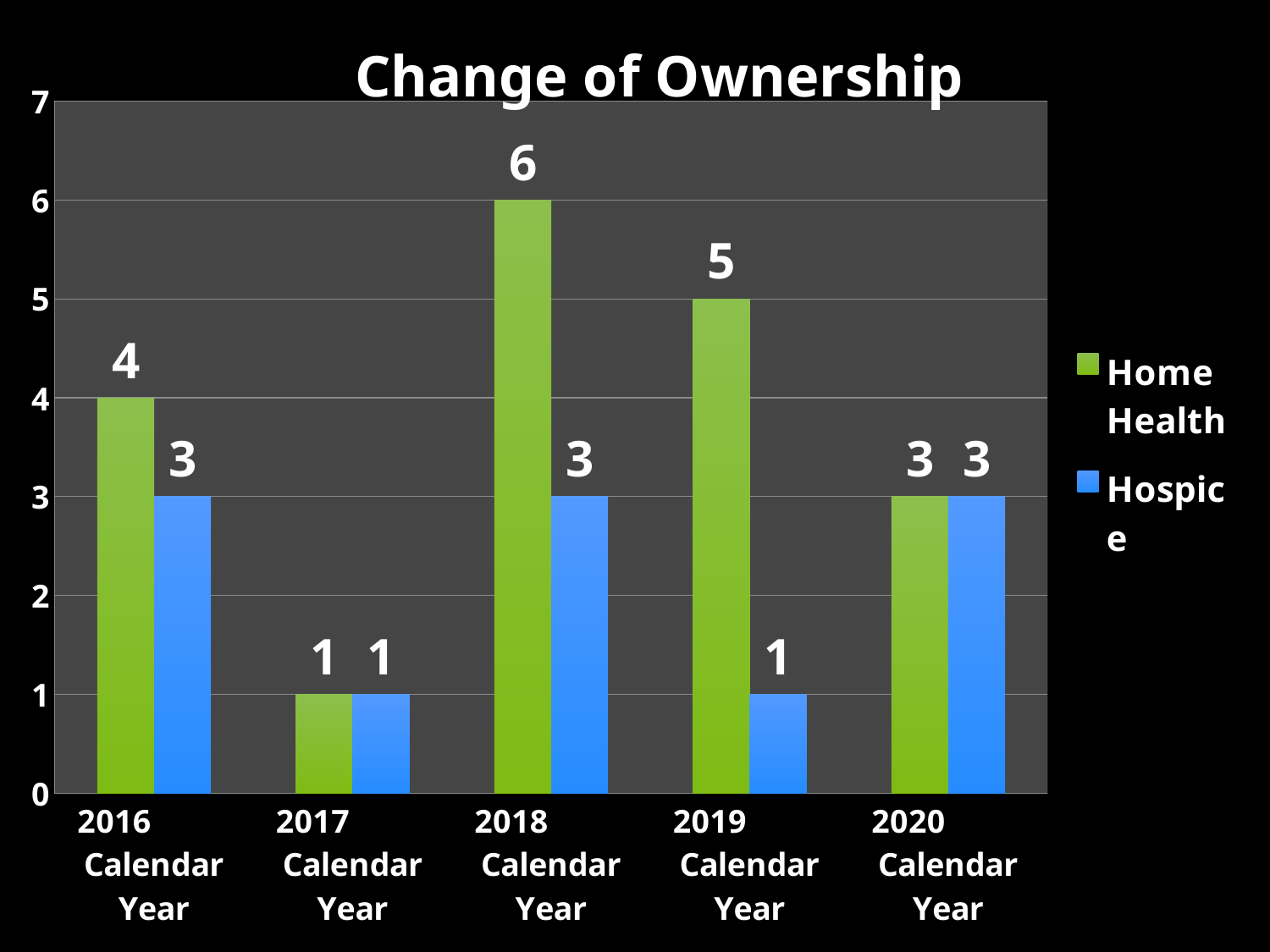
What kind of chart is shown on the slide? Bar chart What is the title of the chart? Change of Ownership Which is larger in the 2016 Calendar Year, Home Health or Hospice? Home Health What is the Home Health value for the 2016 Calendar Year? 4 How many series does the legend list? 2 Which calendar year has the highest Home Health value? 2018 Calendar Year Which calendar year has the lowest Hospice value? 2017 Calendar Year and 2019 Calendar Year (both 1) Which colour represents the Hospice series? Blue What is the difference between the Home Health and Hospice values in the 2019 Calendar Year? 4 What is the Home Health value for the 2018 Calendar Year? 6 How many calendar years are shown on the x axis? 5 What is the Hospice value for the 2019 Calendar Year? 1